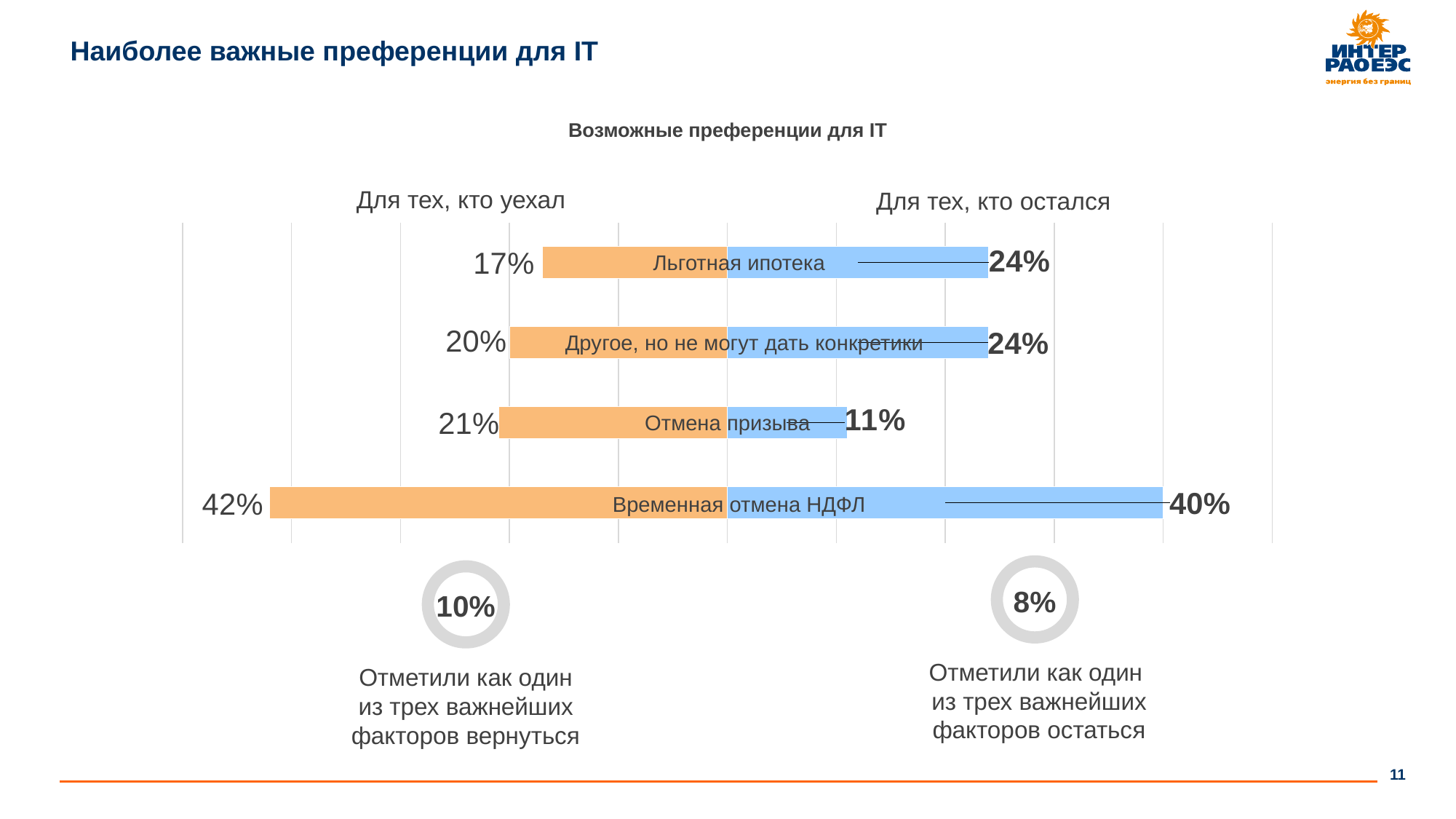
What is the value for «Другое, но не могут дать конкретики» in the «Для тех, кто уехал» series? 20% What is the value for «Льготная ипотека» in the «Для тех, кто уехал» series? 17% What is the value for «Отмена призыва» in the «Для тех, кто остался» series? 11% How many categories are shown in the chart «Возможные преференции для IT»? 4 Which category has the lowest value in the «Для тех, кто остался» series? Отмена призыва What is the difference between the «Для тех, кто уехал» and «Для тех, кто остался» values for «Отмена призыва»? 10% What type of chart is «Возможные преференции для IT»? Bar chart How many series does the chart «Возможные преференции для IT» show? 2 Which category has the highest value in the «Для тех, кто уехал» series? Временная отмена НДФЛ What is the value for «Временная отмена НДФЛ» in the «Для тех, кто остался» series? 40% What colour are the bars for the «Для тех, кто остался» series? Blue For «Льготная ипотека», which series has the larger value: «Для тех, кто уехал» or «Для тех, кто остался»? Для тех, кто остался